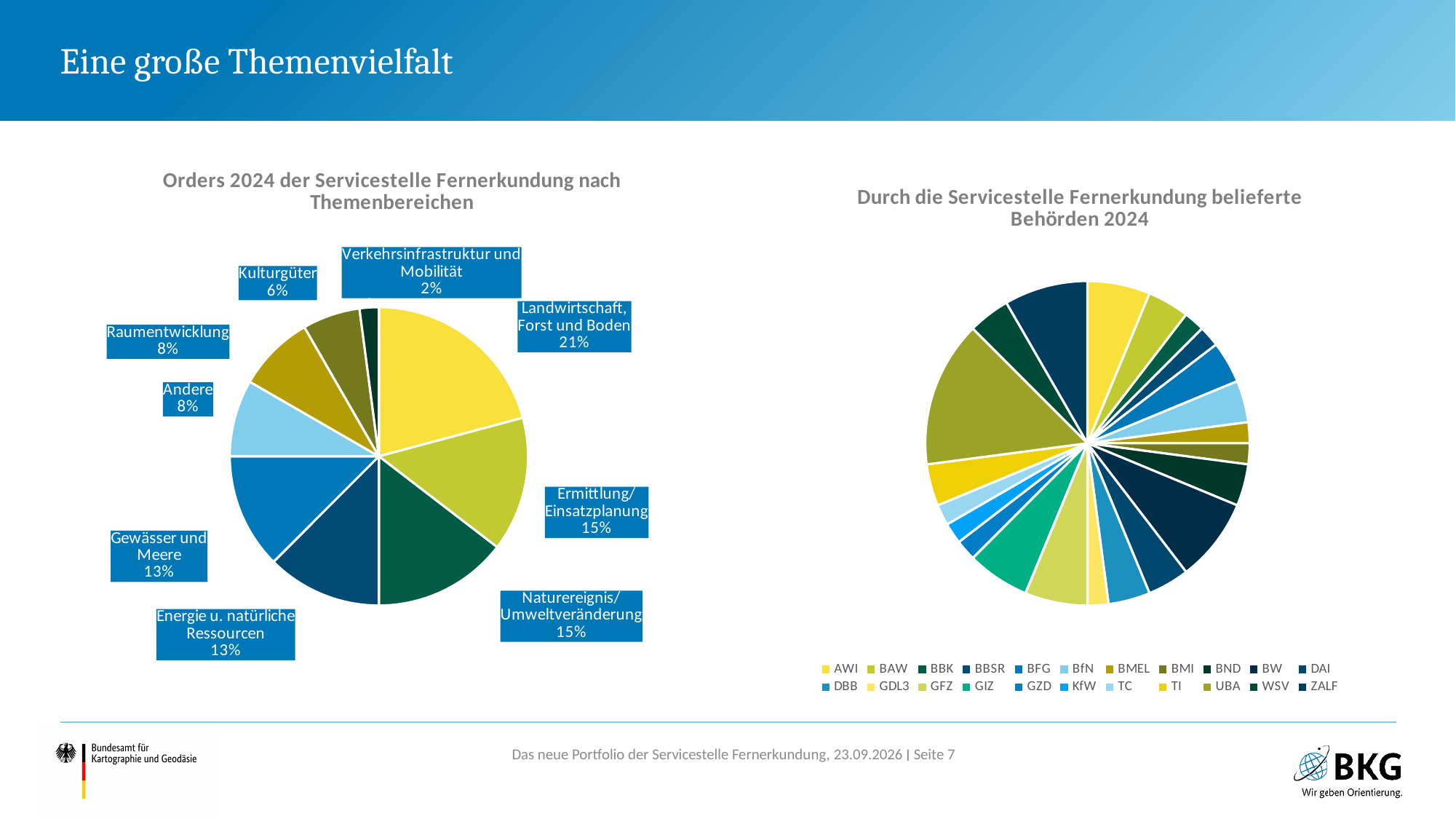
How many entries does the legend of the chart 'Durch die Servicestelle Fernerkundung belieferte Behörden 2024' list? 22 In the chart 'Orders 2024 der Servicestelle Fernerkundung nach Themenbereichen', what is the difference in percentage points between 'Landwirtschaft, Forst und Boden' and 'Ermittlung/Einsatzplanung'? 6 percentage points In the chart 'Orders 2024 der Servicestelle Fernerkundung nach Themenbereichen', which is larger: 'Gewässer und Meere' or 'Raumentwicklung'? Gewässer und Meere In the chart 'Orders 2024 der Servicestelle Fernerkundung nach Themenbereichen', what share does 'Kulturgüter' have? 6% In the chart 'Orders 2024 der Servicestelle Fernerkundung nach Themenbereichen', what share does 'Landwirtschaft, Forst und Boden' have? 21% In the chart 'Durch die Servicestelle Fernerkundung belieferte Behörden 2024', which authority has the largest slice? UBA In the chart 'Orders 2024 der Servicestelle Fernerkundung nach Themenbereichen', what share does 'Verkehrsinfrastruktur und Mobilität' have? 2% How many topic areas are shown in the chart 'Orders 2024 der Servicestelle Fernerkundung nach Themenbereichen'? 9 What is the title of the chart on the right side of the slide? Durch die Servicestelle Fernerkundung belieferte Behörden 2024 In the chart 'Orders 2024 der Servicestelle Fernerkundung nach Themenbereichen', which topic area has the largest share? Landwirtschaft, Forst und Boden What type of chart is 'Orders 2024 der Servicestelle Fernerkundung nach Themenbereichen'? Pie chart In the chart 'Orders 2024 der Servicestelle Fernerkundung nach Themenbereichen', which topic area has the smallest share? Verkehrsinfrastruktur und Mobilität